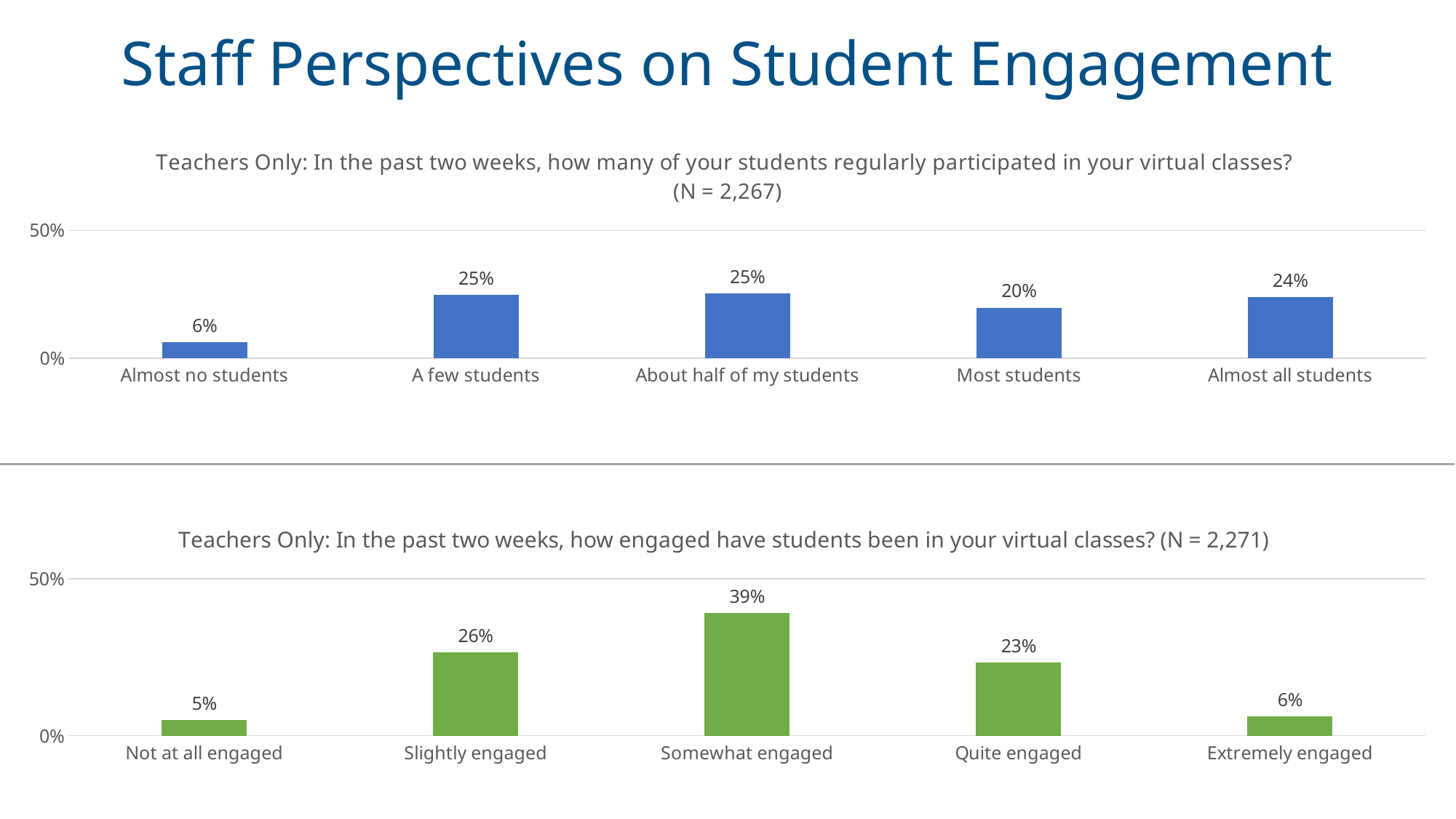
In the bottom chart (student engagement in virtual classes), which is larger: "Slightly engaged" or "Quite engaged"? Slightly engaged In the bottom chart (student engagement in virtual classes), which category has the lowest value? Not at all engaged In the top chart (regular participation in virtual classes), which category has the lowest value? Almost no students In the bottom chart (student engagement in virtual classes), what is the difference between "Somewhat engaged" and "Extremely engaged"? 33% In the top chart (regular participation in virtual classes), how many categories are shown? 5 In the top chart (regular participation in virtual classes), what percentage of teachers answered "Most students"? 20% What kind of chart is the bottom chart (student engagement in virtual classes)? Bar chart In the top chart (regular participation in virtual classes), what percentage of teachers answered "Almost no students"? 6% In the bottom chart (student engagement in virtual classes), what percentage of teachers answered "Somewhat engaged"? 39% What is the sample size (N) shown in the title of the top chart? 2,267 In the bottom chart (student engagement in virtual classes), which category has the highest value? Somewhat engaged In the top chart (regular participation in virtual classes), what is the difference between "Almost all students" and "Most students"? 4%